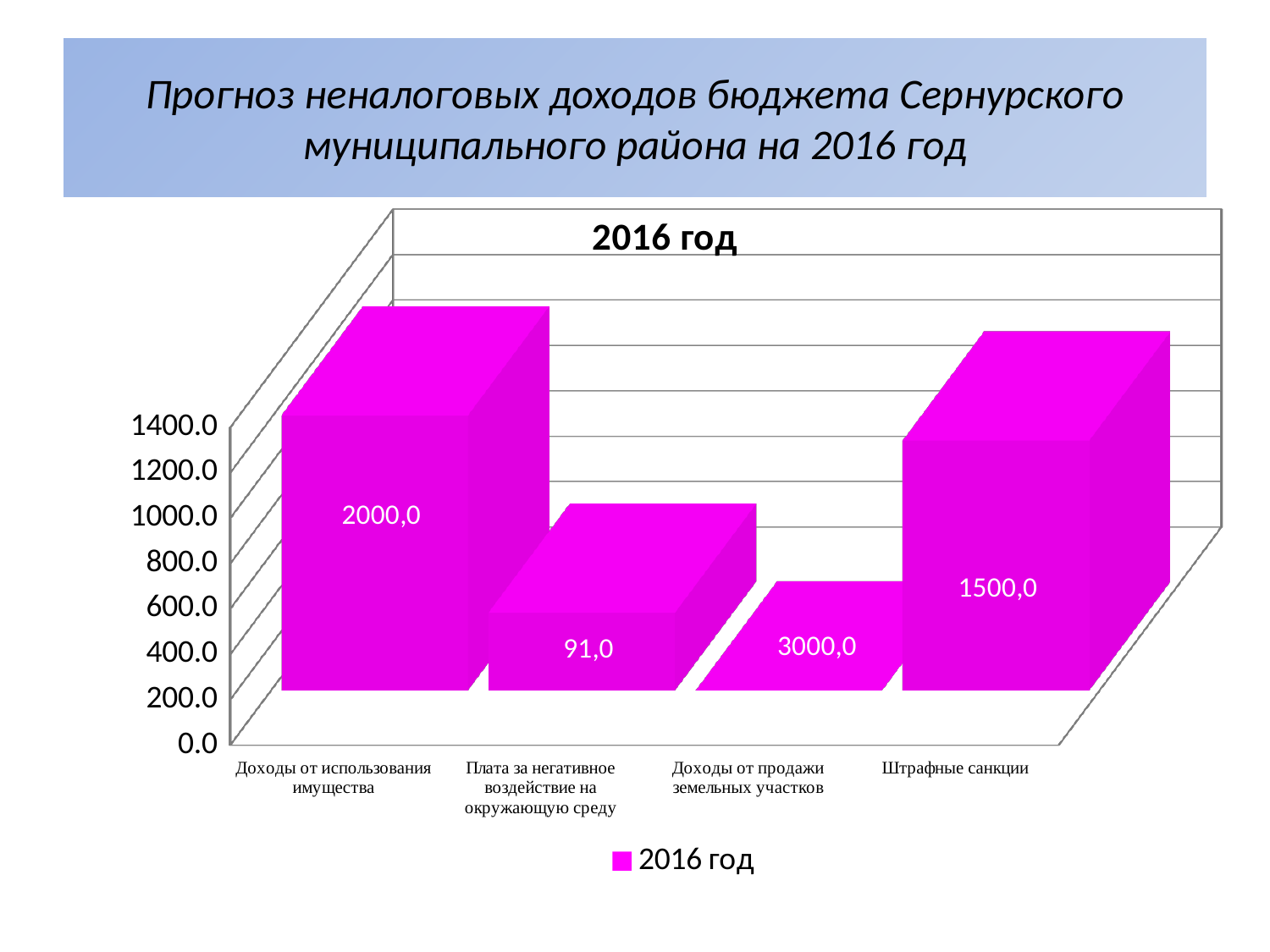
What is the value for Штрафные санкции? 1500,0 What is the difference between the labelled values for Доходы от продажи земельных участков and Плата за негативное воздействие на окружающую среду? 2909,0 What is the title of the chart? 2016 год What colour are the bars in the chart? Magenta How many categories are shown on the x axis? 4 What is the value for Доходы от продажи земельных участков? 3000,0 What is the value for Доходы от использования имущества? 2000,0 How many series does the legend list? 1 What is the difference between the labelled values for Доходы от использования имущества and Штрафные санкции? 500,0 What is the value for Плата за негативное воздействие на окружающую среду? 91,0 What kind of chart is shown on the slide? Bar chart